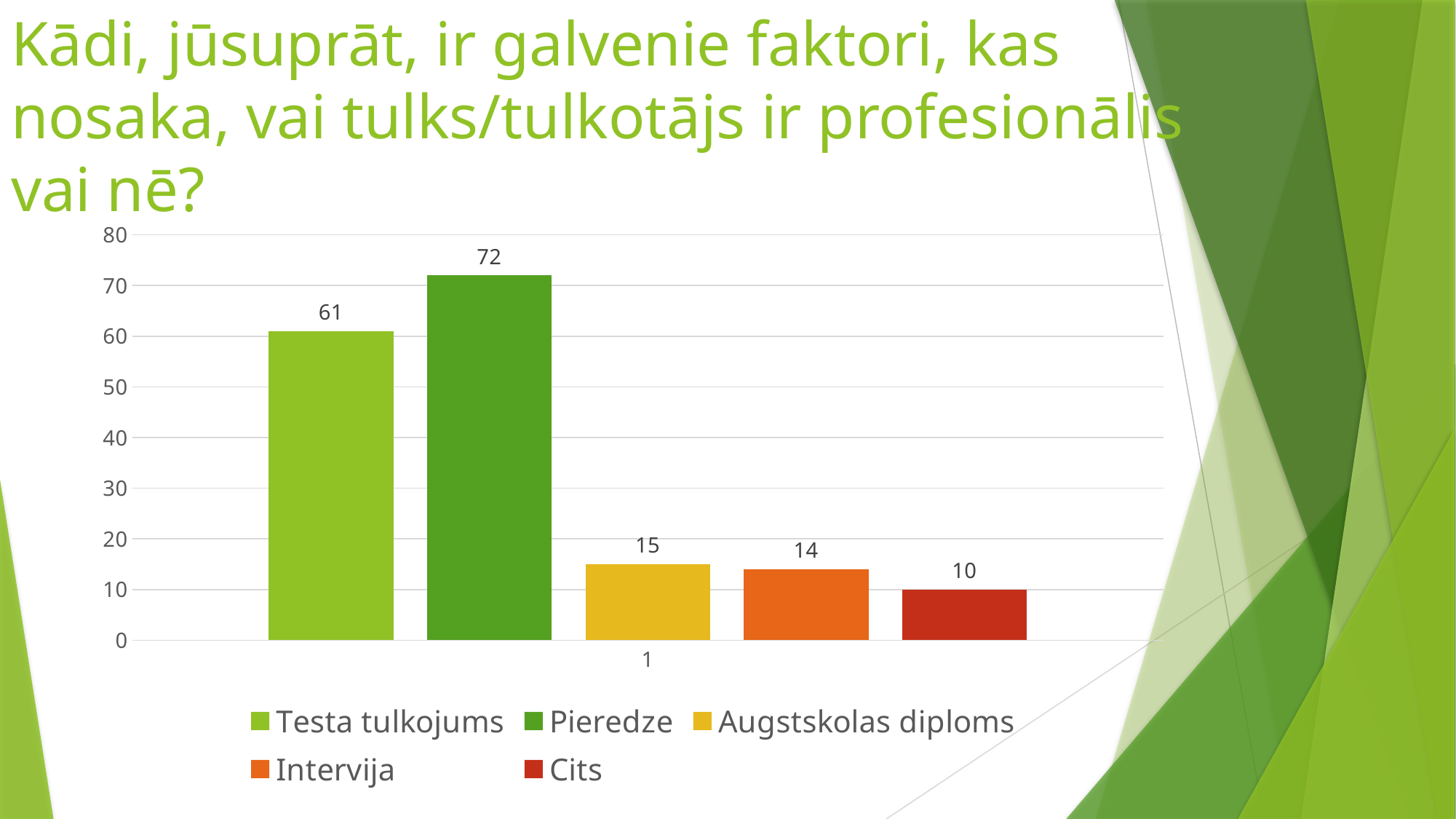
Which series has the highest value? Pieredze How many series does the legend list? 5 Which is larger, the value for Testa tulkojums or the value for Augstskolas diploms? Testa tulkojums What is the value for Pieredze? 72 What is the value for Augstskolas diploms? 15 What colour is the bar for Intervija? Orange Which series has the lowest value? Cits What is the value for Cits? 10 What kind of chart is shown on the slide? Bar chart What is the value for Testa tulkojums? 61 What is the value for Intervija? 14 What is the difference between the values for Pieredze and Testa tulkojums? 11